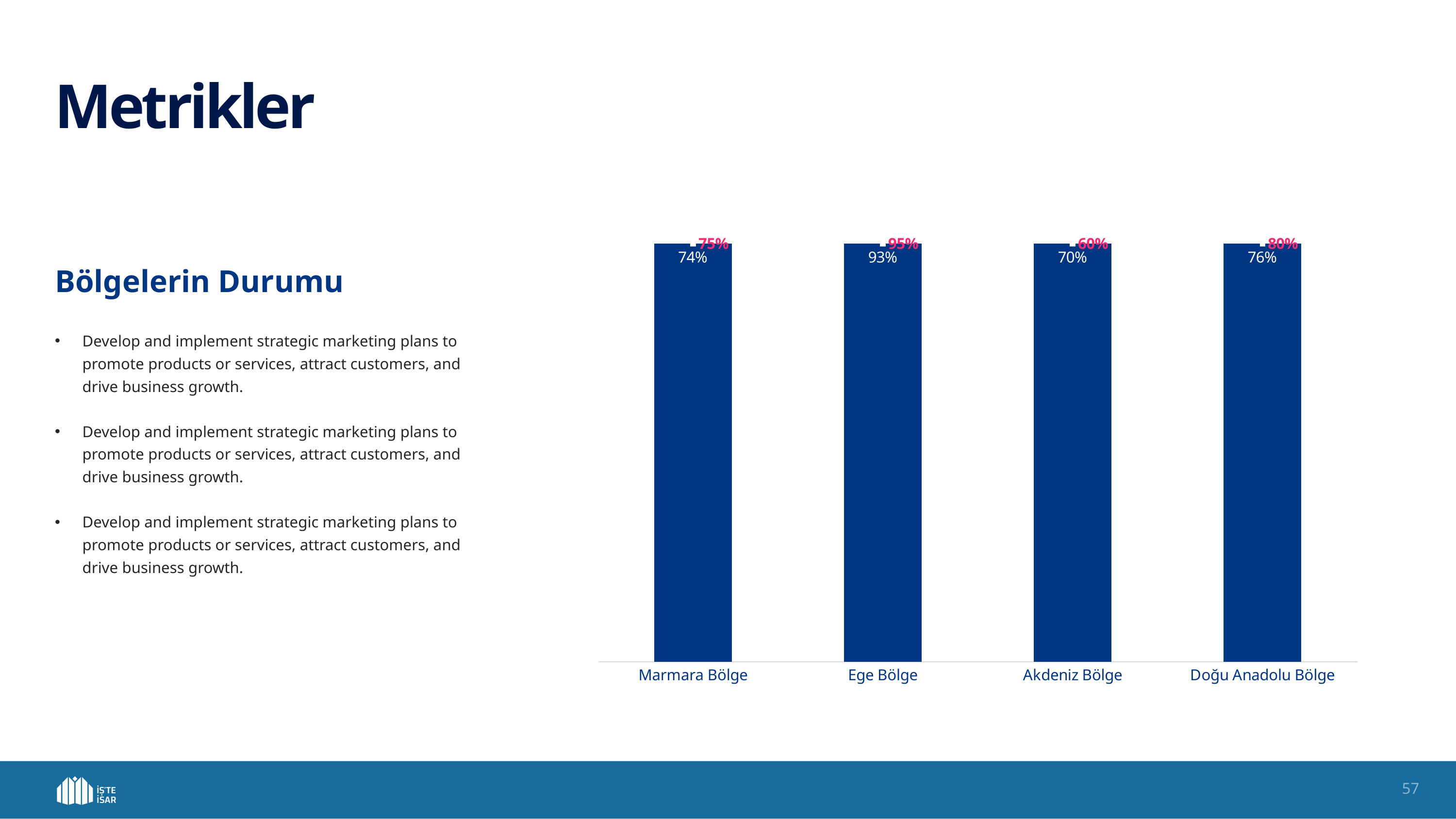
Which region has the highest white data label value? Ege Bölge What is the pink label shown above the bar for Ege Bölge? 95% What is the white data label shown inside the bar for Marmara Bölge? 74% How many regions are shown on the x axis of the chart? 4 What is the difference between the white data label values for Ege Bölge and Marmara Bölge? 19% What type of chart is shown on the slide? Bar chart What is the white data label shown inside the bar for Ege Bölge? 93% What is the pink label shown above the bar for Akdeniz Bölge? 60% What is the white data label shown inside the bar for Doğu Anadolu Bölge? 76% Which region has the lowest white data label value? Akdeniz Bölge What is the white data label shown inside the bar for Akdeniz Bölge? 70% Which region has a larger white data label value, Doğu Anadolu Bölge or Marmara Bölge? Doğu Anadolu Bölge